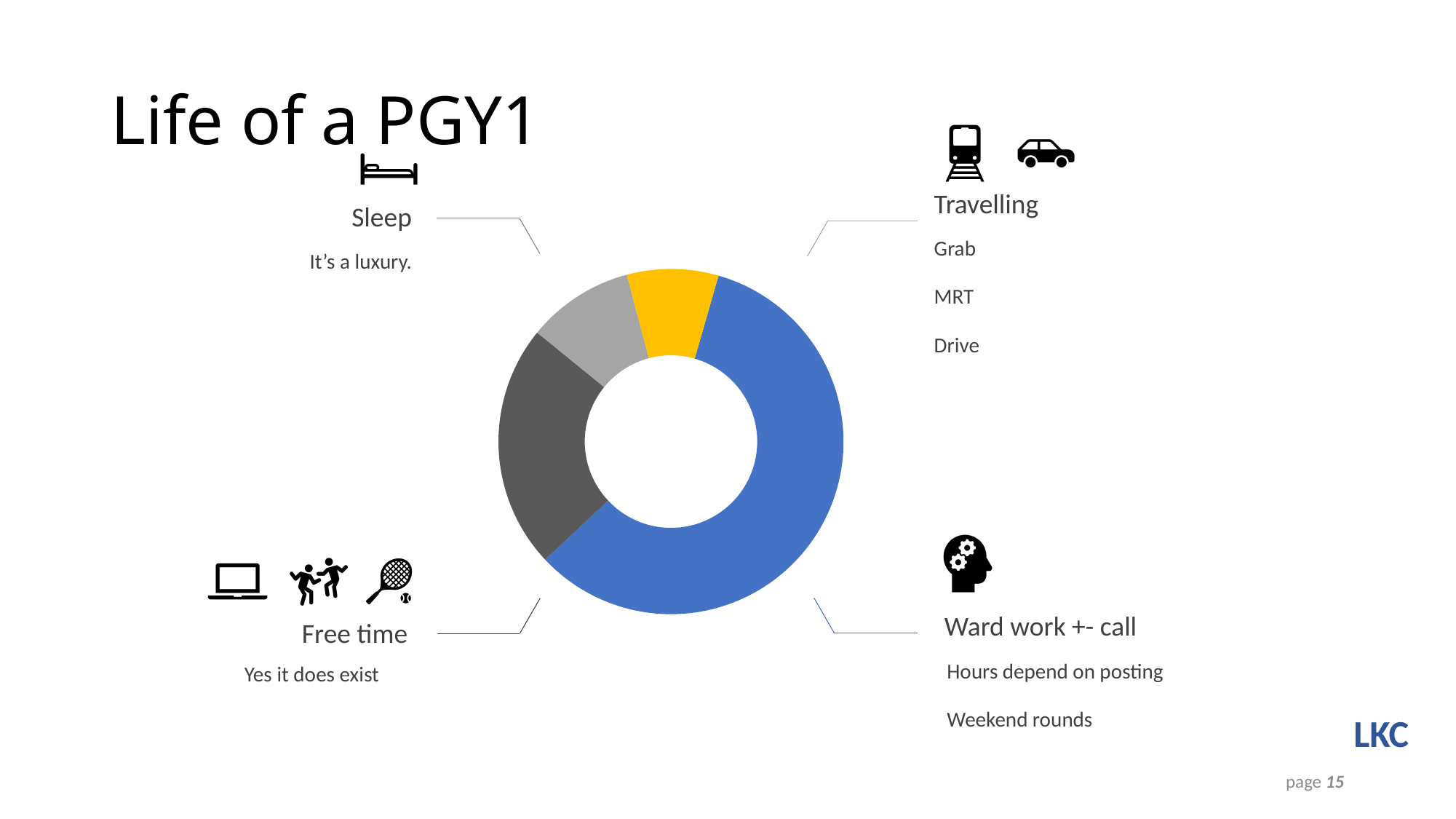
Does the Ward work +- call slice take up more or less than half of the donut chart? More What colour is the largest slice of the donut chart? Blue What is the title of the slide containing the donut chart? Life of a PGY1 Which slice is larger, Ward work +- call or Free time? Ward work +- call Which category takes up the largest share of the donut chart? Ward work +- call Which category takes up the smallest share of the donut chart? Travelling What kind of chart is shown on the slide? Pie chart (donut) Which slice is larger, Free time or Sleep? Free time How many slices does the donut chart have? 4